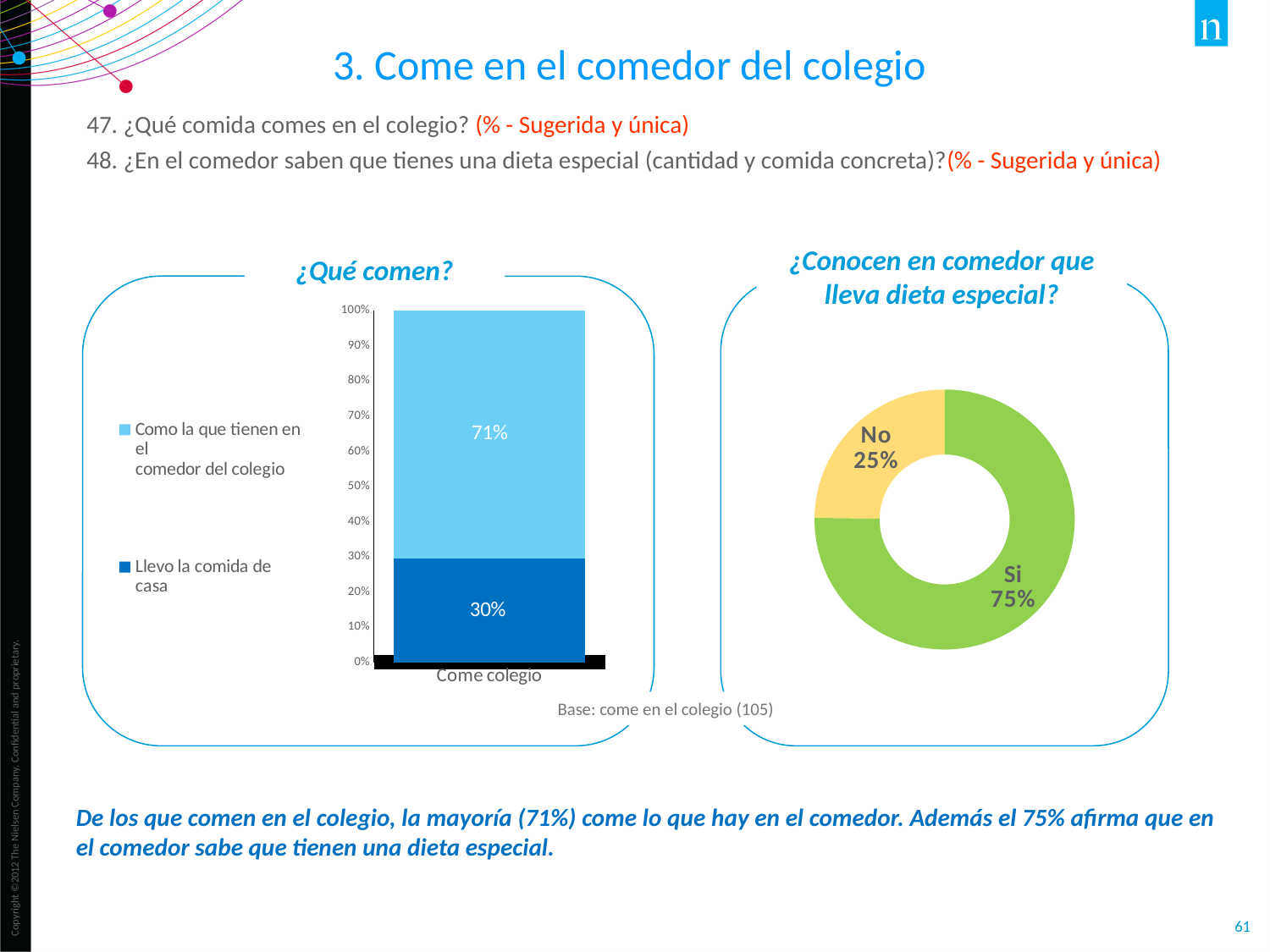
In the '¿Qué comen?' chart, what percentage is shown for 'Llevo la comida de casa'? 30% What kind of chart is the '¿Conocen en comedor que lleva dieta especial?' chart? Doughnut chart In the '¿Conocen en comedor que lleva dieta especial?' chart, what percentage answered 'Si'? 75% What kind of chart is the '¿Qué comen?' chart? Stacked bar chart How many series does the legend of the '¿Qué comen?' chart list? 2 In the '¿Conocen en comedor que lleva dieta especial?' chart, what percentage answered 'No'? 25% In the '¿Qué comen?' chart, what percentage is shown for 'Como la que tienen en el comedor del colegio'? 71% In the '¿Qué comen?' chart, which series has the larger value, 'Como la que tienen en el comedor del colegio' or 'Llevo la comida de casa'? Como la que tienen en el comedor del colegio In the '¿Qué comen?' chart, what is the difference between the 71% and 30% segments? 41% What is the category label on the x axis of the '¿Qué comen?' chart? Come colegio In the '¿Conocen en comedor que lleva dieta especial?' chart, which slice is the largest? Si In the '¿Conocen en comedor que lleva dieta especial?' chart, what is the difference between the 'Si' and 'No' shares? 50%